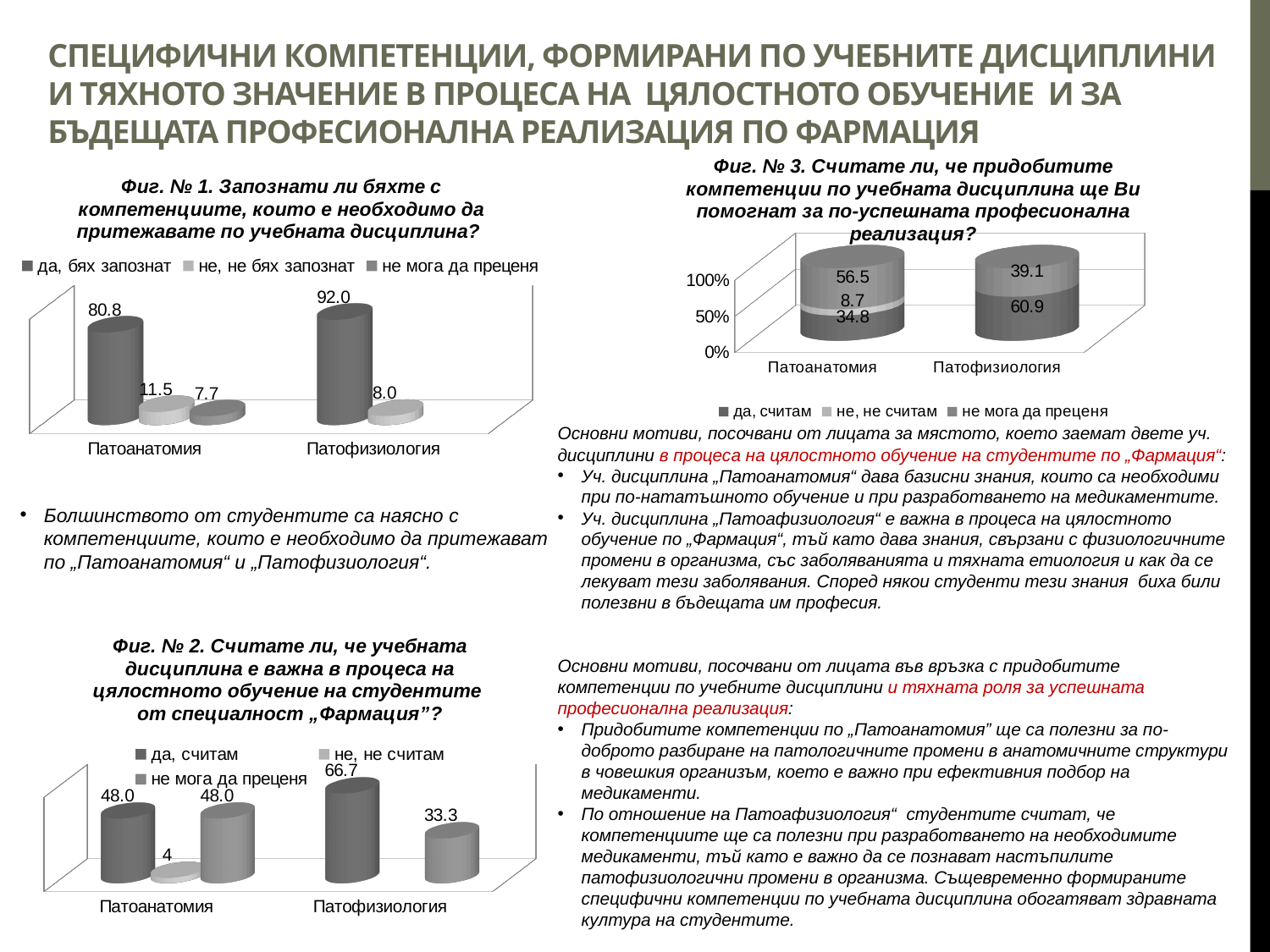
What kind of chart is Фиг. № 3? Stacked bar chart In Фиг. № 3, what is the value for "да, считам" for Патофизиология? 60.9 In Фиг. № 1, what is the difference between the "да, бях запознат" values for Патофизиология and Патоанатомия? 11.2 In Фиг. № 2, which is larger for Патофизиология: "да, считам" or "не мога да преценя"? да, считам In Фиг. № 3, what is the value for "не мога да преценя" for Патоанатомия? 56.5 In Фиг. № 3, what is the difference between the "да, считам" values for Патофизиология and Патоанатомия? 26.1 In Фиг. № 1, how many series does the legend list? 3 In Фиг. № 1, what is the value for "да, бях запознат" for Патофизиология? 92.0 In Фиг. № 2, what is the value for "не, не считам" for Патоанатомия? 4 In Фиг. № 1, what is the value for "не мога да преценя" for Патоанатомия? 7.7 In Фиг. № 2, what is the value for "да, считам" for Патофизиология? 66.7 In Фиг. № 1, what is the value for "да, бях запознат" for Патоанатомия? 80.8